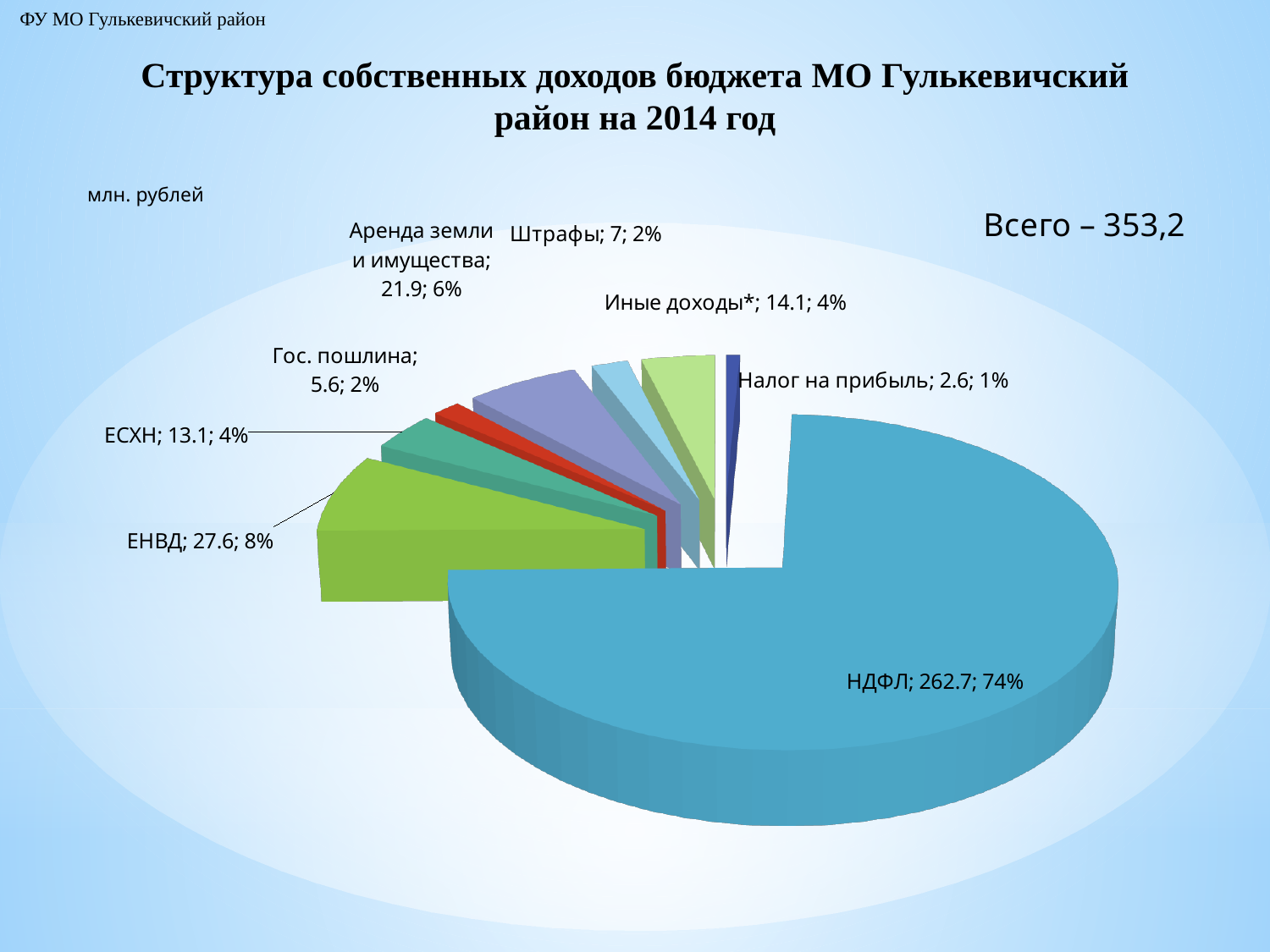
What kind of chart is shown on the slide? pie chart Which category has the smallest slice of the pie? Налог на прибыль Which is larger, the value for Штрафы or the value for Гос. пошлина? Штрафы What total is stated on the slide next to the chart (Всего)? 353,2 Which category has the largest slice of the pie? НДФЛ What is the value for Аренда земли и имущества? 21.9 What share of the pie does Налог на прибыль represent? 1% What is the value for Иные доходы*? 14.1 How many slices does the pie chart have? 8 What is the difference between the values for ЕНВД and ЕСХН? 14.5 What share of the pie does ЕНВД represent? 8% What is the value for НДФЛ? 262.7